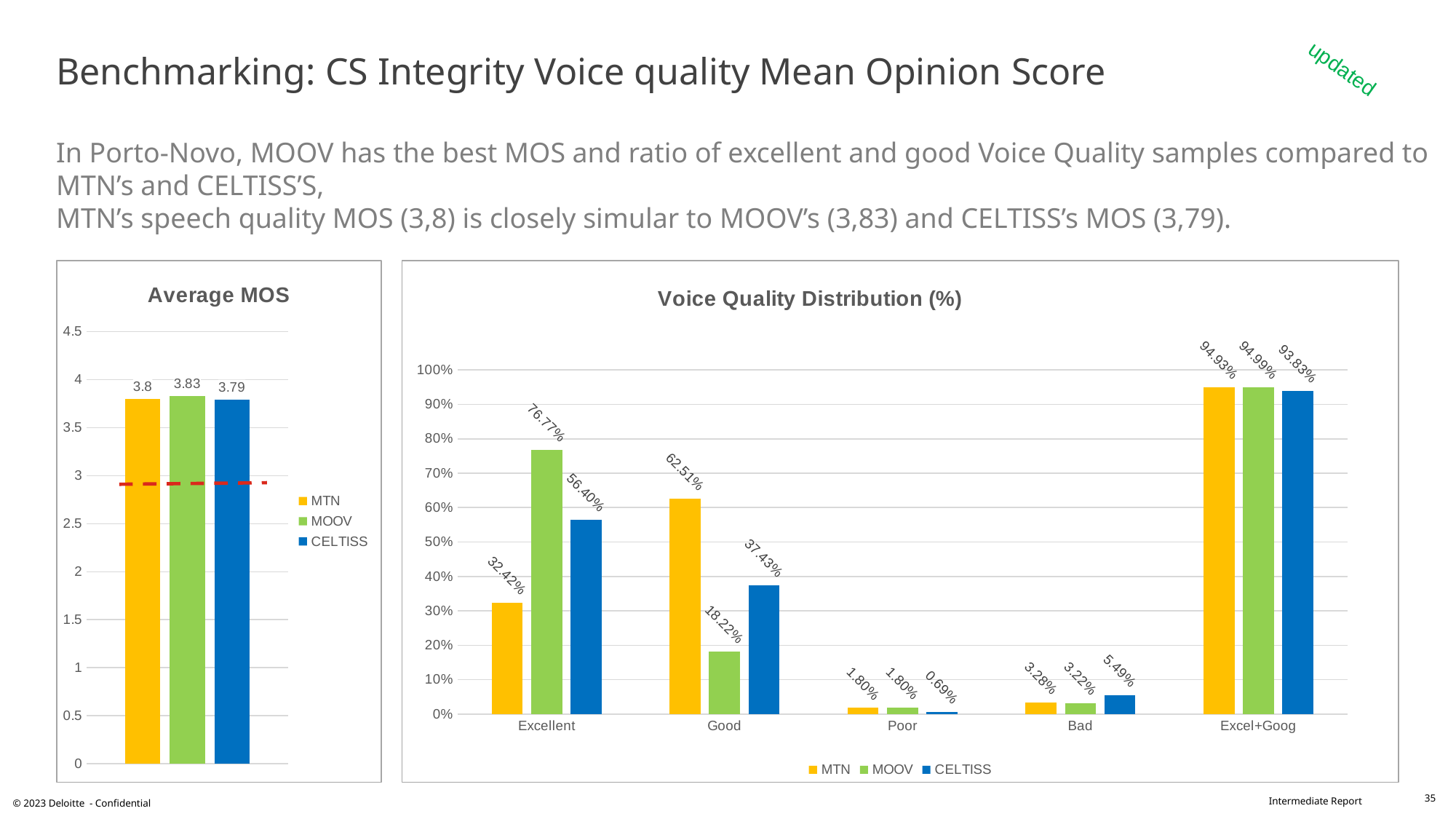
In the Average MOS chart, how many series does the legend list? 3 In the Voice Quality Distribution (%) chart, is the MTN value for Good larger or the CELTISS value for Good? MTN In the Voice Quality Distribution (%) chart, what is the MOOV value for Excellent? 76.77% In the Average MOS chart, what is the difference between the MOOV and MTN values? 0.03 In the Voice Quality Distribution (%) chart, what is the CELTISS value for Good? 37.43% In the Average MOS chart, what is the value for CELTISS? 3.79 In the Voice Quality Distribution (%) chart, which operator has the lowest value for Poor? CELTISS In the Voice Quality Distribution (%) chart, how many categories are shown on the x axis? 5 What kind of chart is the Voice Quality Distribution (%) chart? Bar chart In the Average MOS chart, what is the value for MOOV? 3.83 In the Voice Quality Distribution (%) chart, what is the difference between the MOOV and MTN values for Excellent? 44.35% In the Voice Quality Distribution (%) chart, which operator has the highest value for Excellent? MOOV